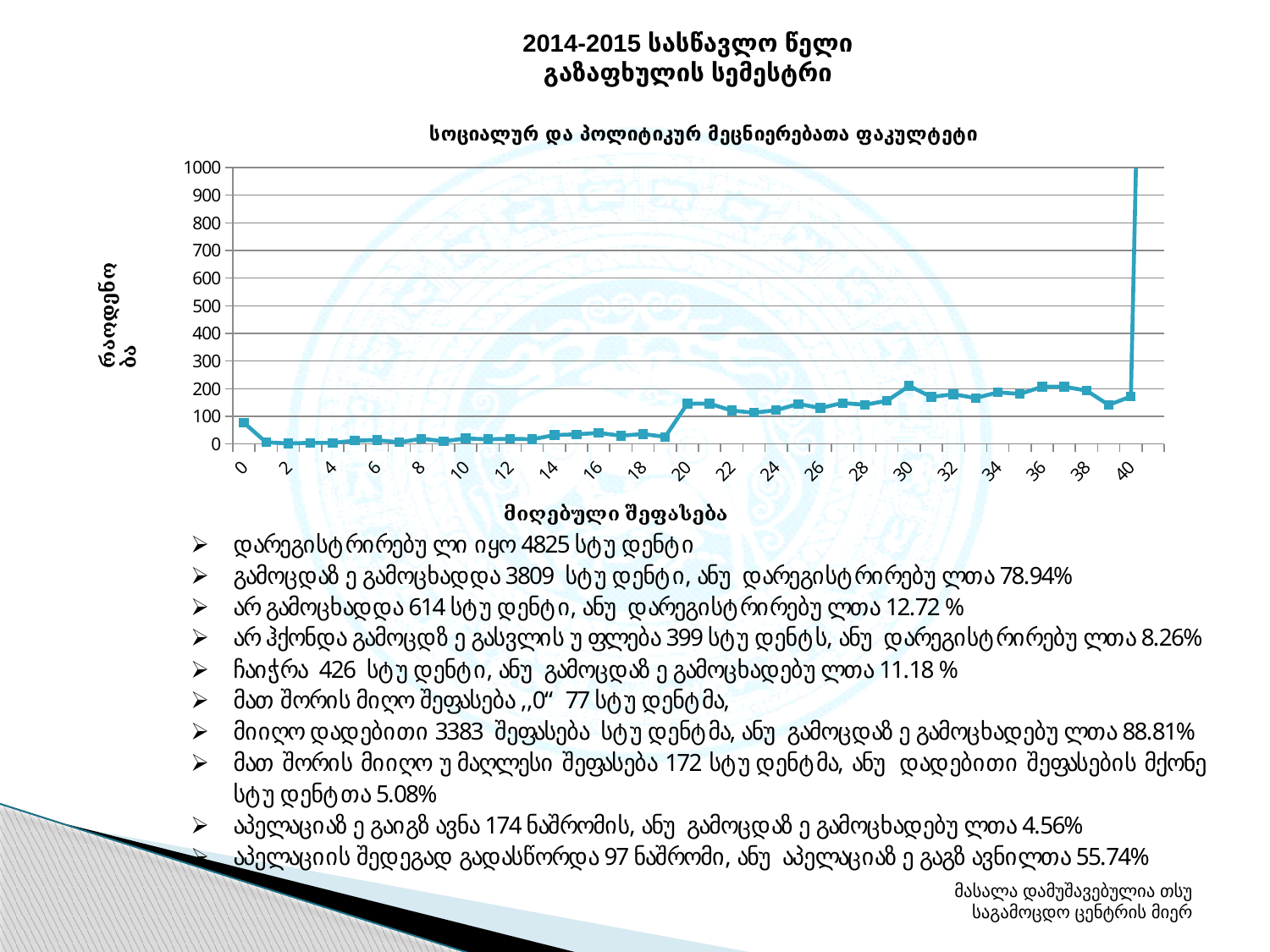
Is the value for grade 24 greater or less than 300? less Is the value for grade 20 greater or less than 100? greater Is the value for grade 30 greater or less than 100? greater What is the label of the x axis of the chart? მიღებული შეფასება What is the title of the chart? სოციალურ და პოლიტიკურ მეცნიერებათა ფაკულტეტი Which is larger, the value for grade 20 or the value for grade 18? grade 20 Which is larger, the value for grade 0 or the value for grade 4? grade 0 Do the values generally rise or fall when moving from grade 0 to grade 40 along the x axis? rise What kind of chart is shown on the slide? line chart